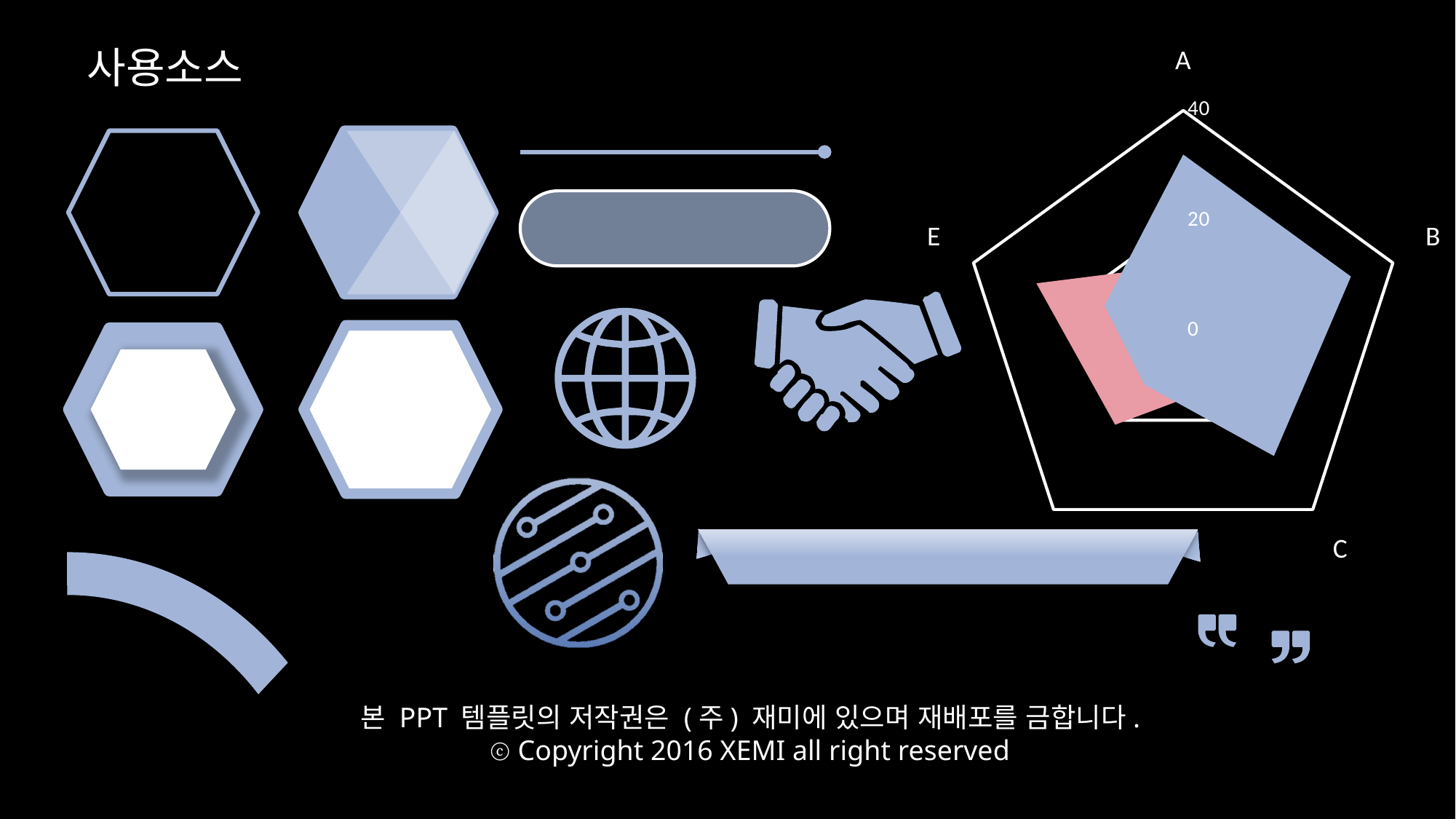
Is the blue series' value for A greater or less than 20? greater How many data series are plotted on the radar chart? 2 What kind of chart is shown on the right side of the slide? radar chart Is the blue series' value for C greater or less than 20? greater At axis E, which series has the larger value, blue or pink? pink Which axis label appears at the top vertex of the radar chart? A Is the pink series' value for E greater or less than 20? greater What colours are the two filled series on the radar chart? blue and pink What is the highest value shown on the radar chart's scale? 40 How many axes (vertices) does the radar chart have? 5 At axis B, which series has the larger value, blue or pink? blue